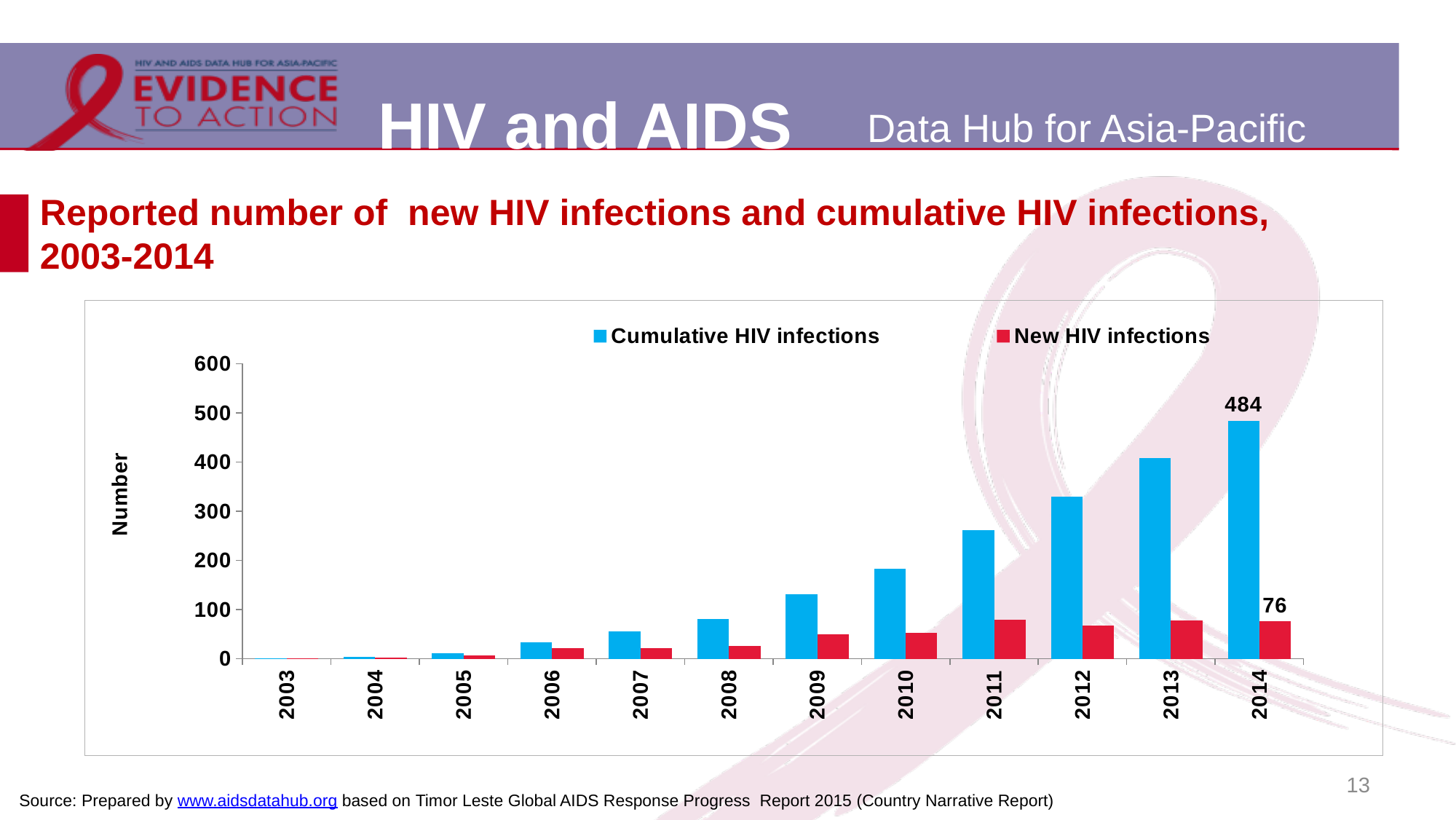
What is the title of the y axis? Number Which year has the highest value for Cumulative HIV infections? 2014 In 2014, which is larger: Cumulative HIV infections or New HIV infections? Cumulative HIV infections How many series does the legend list? 2 What is the value for Cumulative HIV infections in 2014? 484 Is the value for Cumulative HIV infections in 2010 greater or less than 200? less What is the difference between Cumulative HIV infections and New HIV infections in 2014? 408 What kind of chart is shown on the slide? Bar chart What is the value for New HIV infections in 2014? 76 Do the values for Cumulative HIV infections rise or fall from 2003 to 2014? Rise Is the value for Cumulative HIV infections in 2012 greater or less than 300? greater How many years are shown on the x axis? 12